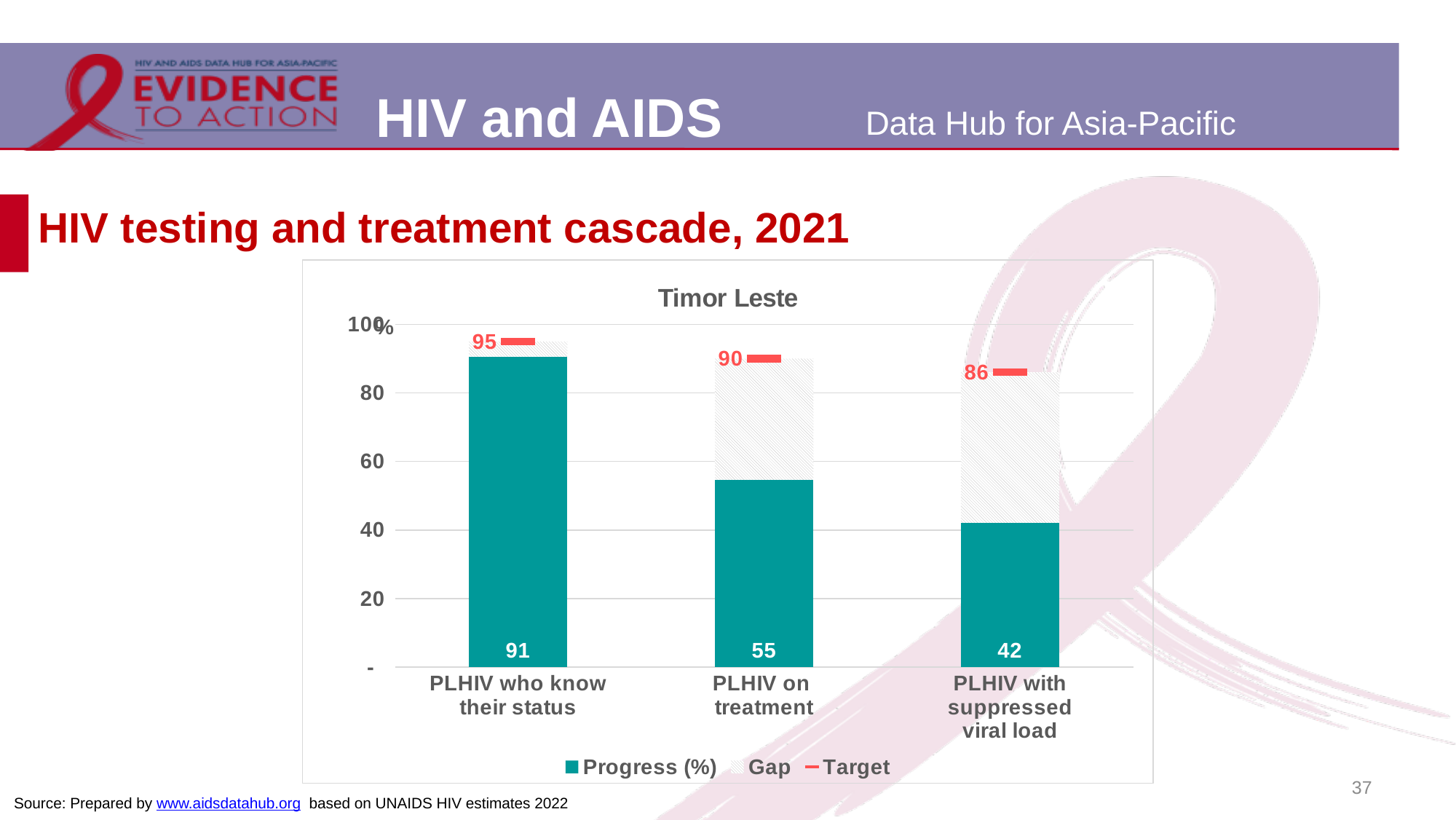
What is the Target value for PLHIV with suppressed viral load? 86 Do the Progress (%) values rise or fall from left to right along the x axis? fall How many categories are shown on the x axis? 3 Which is larger: the Progress (%) value for PLHIV on treatment or for PLHIV with suppressed viral load? PLHIV on treatment How many series does the legend list? 3 What is the Progress (%) value for PLHIV who know their status? 91 Which category has the highest Progress (%) value? PLHIV who know their status What is the Progress (%) value for PLHIV with suppressed viral load? 42 What is the Target value for PLHIV on treatment? 90 What is the difference between the Target and the Progress (%) value for PLHIV on treatment? 35 Which category has the lowest Progress (%) value? PLHIV with suppressed viral load What is the Progress (%) value for PLHIV on treatment? 55